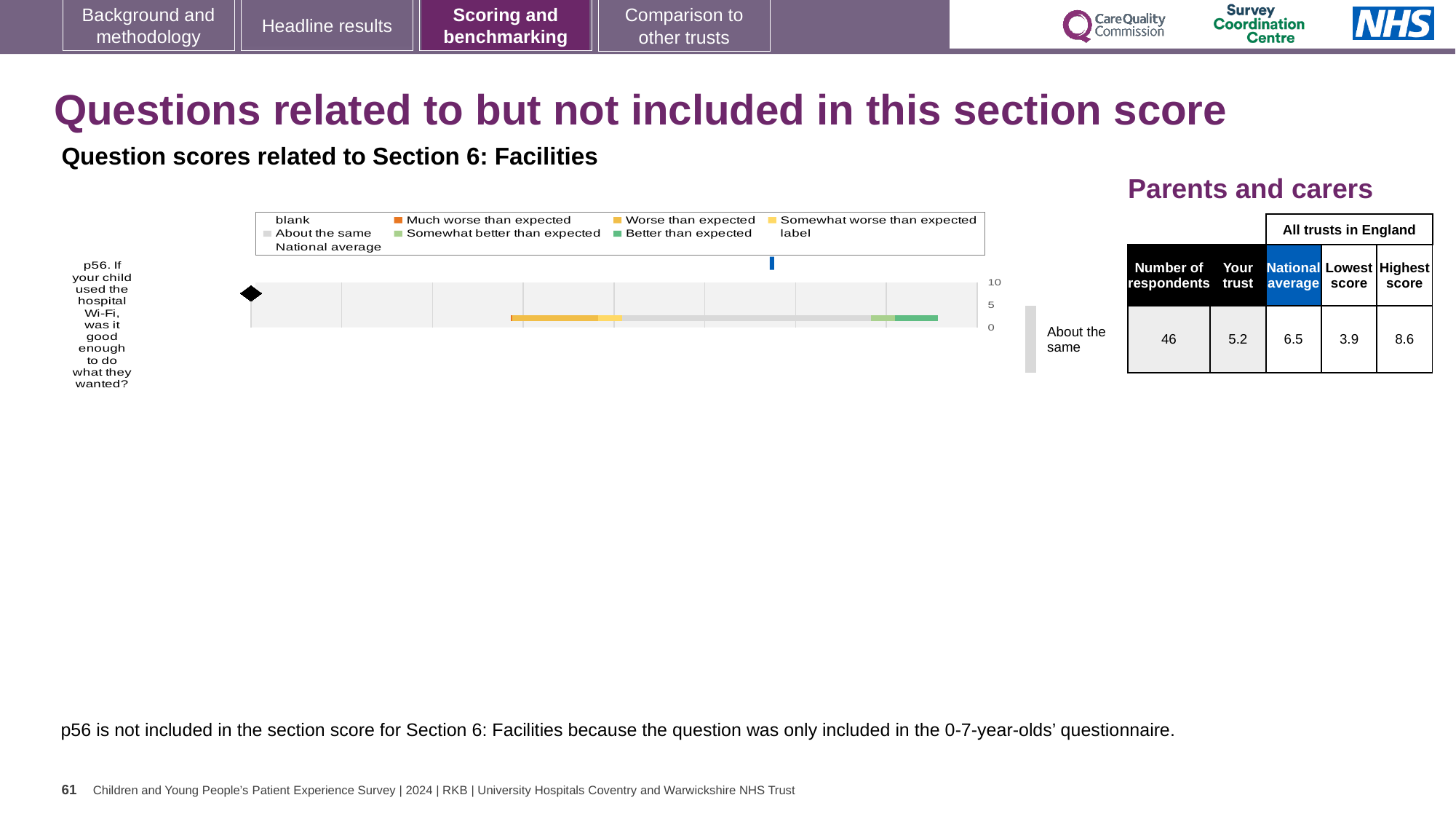
What is the national average score for p56? 6.5 Which benchmark category is the trust's p56 score placed in? About the same What is the difference between the national average and the 'Your trust' score for p56? 1.3 Which question number is plotted in the chart? p56 What is the highest score among all trusts in England for p56? 8.6 How many respondents answered p56? 46 What type of chart is shown on the slide? bar chart How many survey questions are plotted in the chart? 1 What is the 'Your trust' score for p56? 5.2 What is the lowest score among all trusts in England for p56? 3.9 What is the difference between the highest and lowest scores for p56? 4.7 Which is larger for p56, the 'Your trust' score or the national average? National average